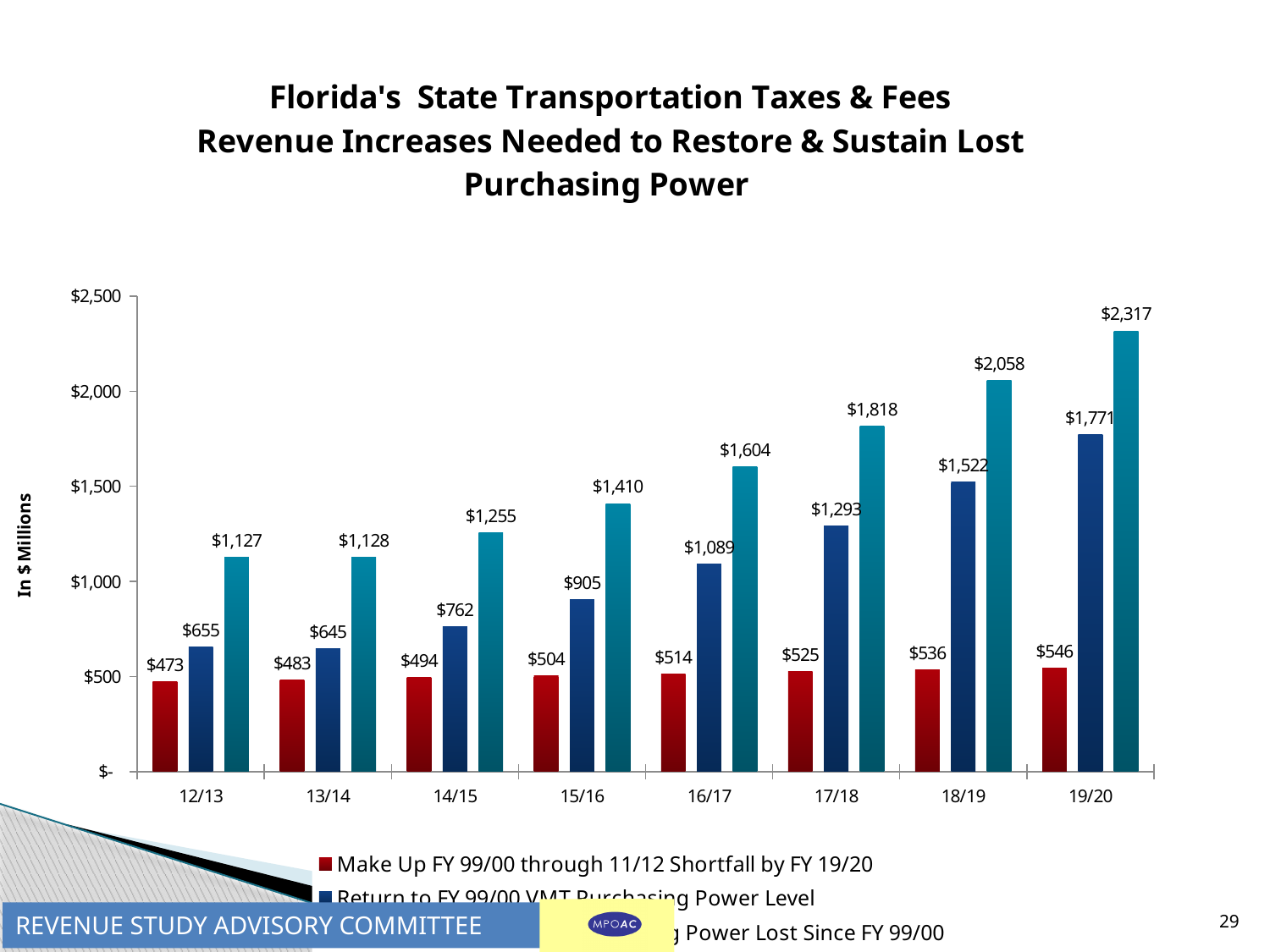
What is the value of the 'Make Up FY 99/00 through 11/12 Shortfall by FY 19/20' series for 12/13? $473 How many series does the legend list? 3 In which fiscal year is the 'Return to FY 99/00 VMT Purchasing Power Level' series lowest? 13/14 What is the difference between the teal bar and the 'Return to FY 99/00 VMT Purchasing Power Level' bar for 18/19? $536 Is the value of the 'Return to FY 99/00 VMT Purchasing Power Level' series for 17/18 greater or less than $1,000? greater In which fiscal year is the teal series highest? 19/20 Does the 'Make Up FY 99/00 through 11/12 Shortfall by FY 19/20' series rise or fall from 12/13 to 19/20? rise How many fiscal years are shown on the x axis? 8 What kind of chart is shown on the slide? bar chart Which is larger for 15/16: the 'Return to FY 99/00 VMT Purchasing Power Level' value or the 'Make Up FY 99/00 through 11/12 Shortfall by FY 19/20' value? Return to FY 99/00 VMT Purchasing Power Level What is the value of the 'Return to FY 99/00 VMT Purchasing Power Level' series for 16/17? $1,089 What is the value of the tallest (teal) bar for 19/20? $2,317